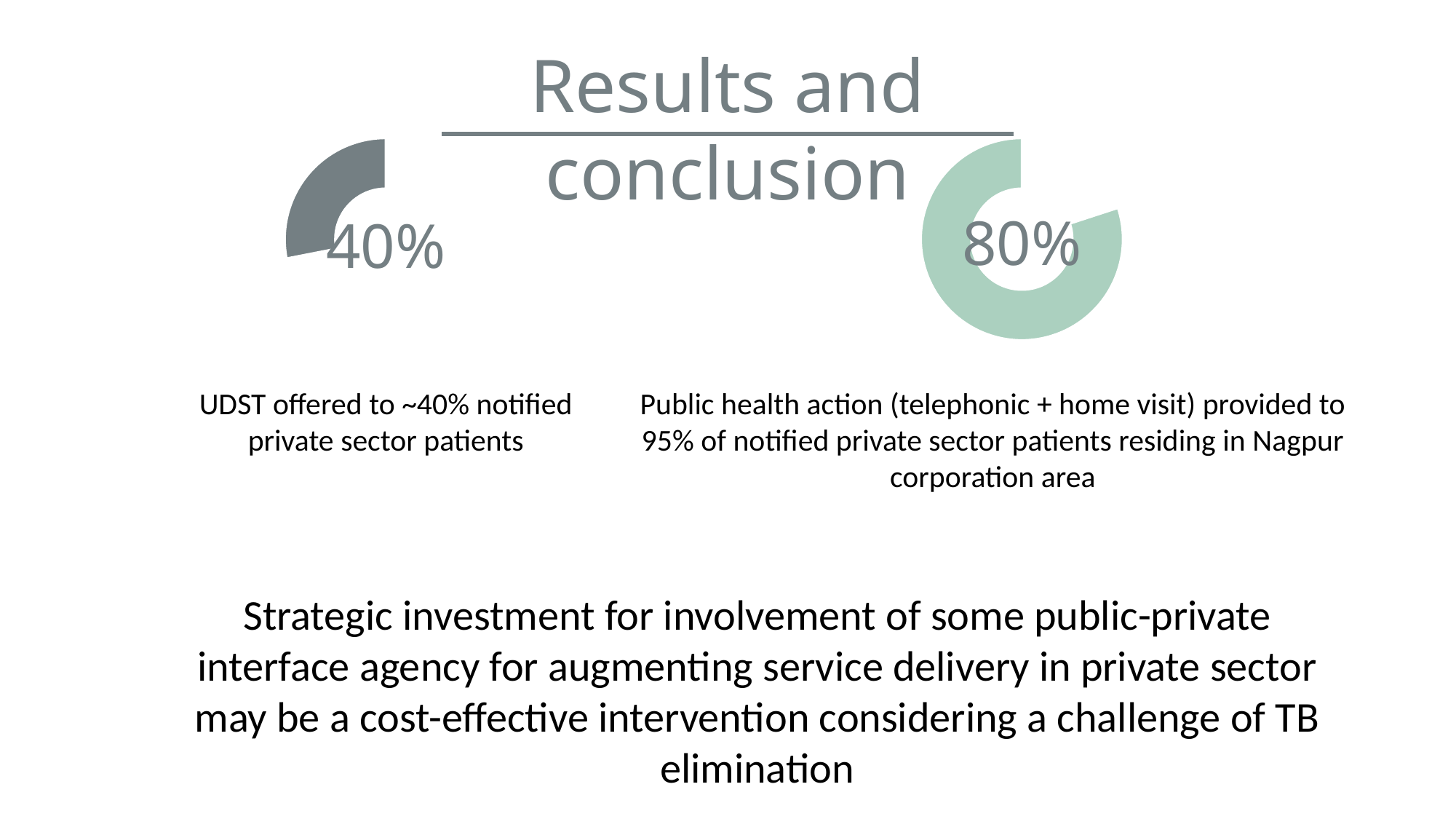
What colour is the ring of the left chart showing 40%? grey Is the value shown on the right chart greater or less than 50%? greater What percentage is shown on the right chart? 80% What kind of chart is used to show the 40% and 80% values? doughnut chart Which chart shows the lowest percentage? the left chart (40%) Which chart shows the larger percentage, the left chart or the right chart? the right chart Is the value shown on the left chart greater or less than 50%? less What colour is the ring of the right chart showing 80%? green What is the difference between the percentage on the right chart and the percentage on the left chart? 40% What percentage is shown on the left chart? 40% How many charts are shown on the slide? 2